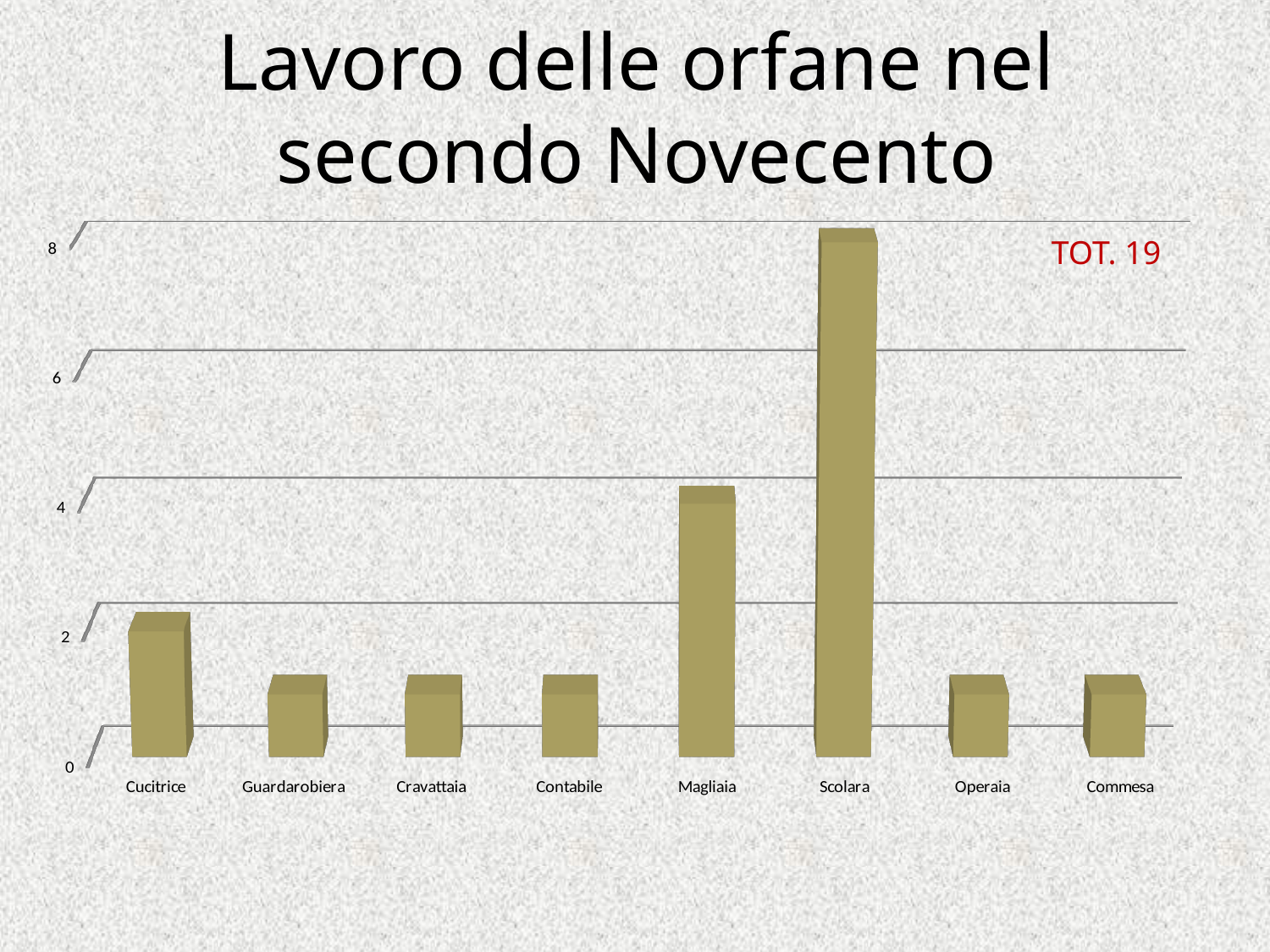
Which is larger, the value for Magliaia or the value for Cucitrice? Magliaia Is the value for Guardarobiera greater or less than 2? less Is the value for Operaia greater or less than 2? less What type of chart is shown on the slide? bar chart What is the value for Cucitrice? 2 What total is written in red text on the chart? TOT. 19 What is the value for Scolara? 8 What is the value for Magliaia? 4 How many categories (occupations) are shown on the x axis of the chart? 8 What is the title of the chart on the slide? Lavoro delle orfane nel secondo Novecento What is the difference between the values for Scolara and Magliaia? 4 Which occupation has the highest bar in the chart? Scolara